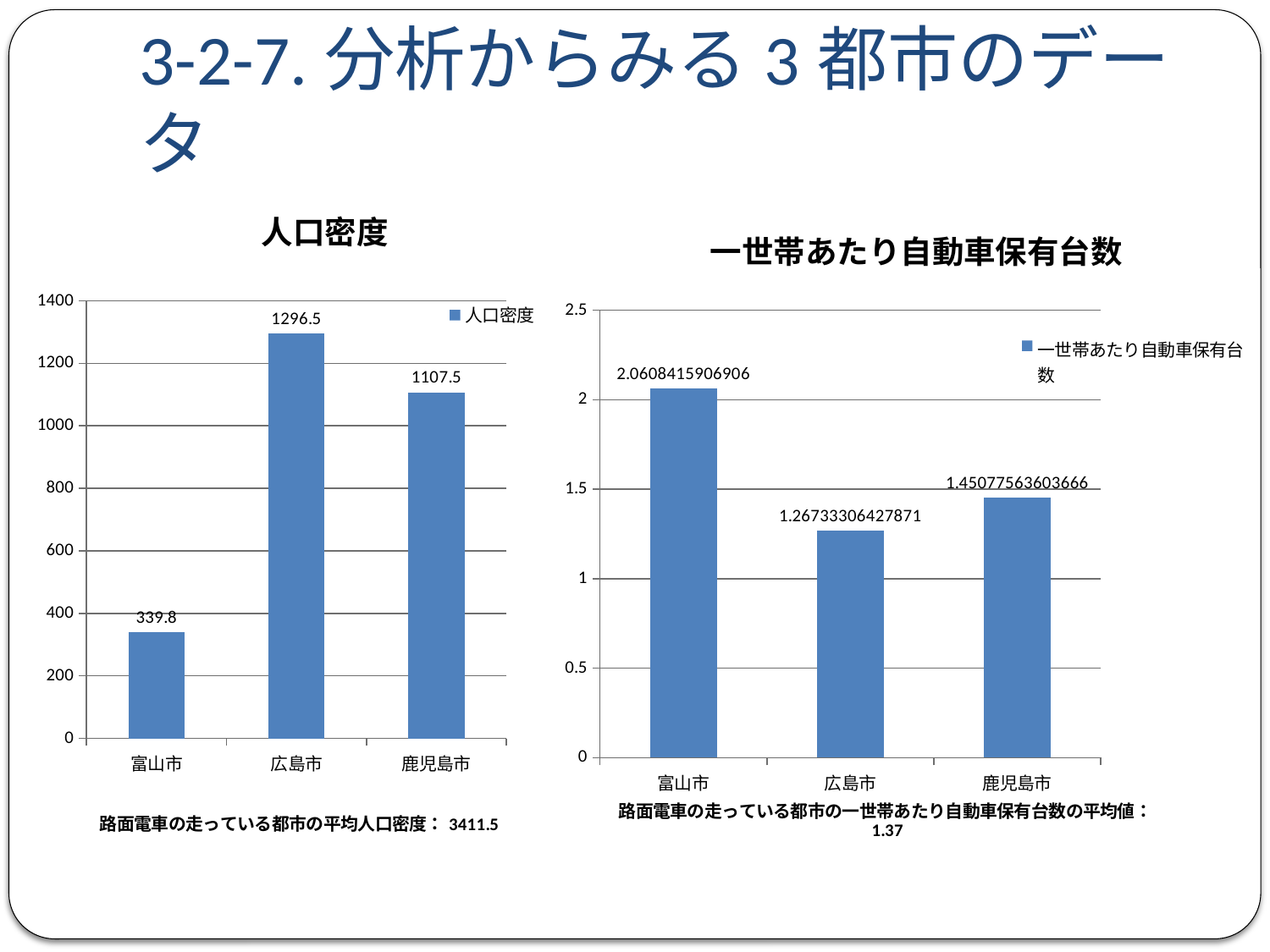
How many cities are shown in the 人口密度 chart? 3 In the 一世帯あたり自動車保有台数 chart, which is larger: the value for 鹿児島市 or 広島市? 鹿児島市 In the 人口密度 chart, what is the value for 富山市? 339.8 In the 人口密度 chart, which city has the highest population density? 広島市 In the 一世帯あたり自動車保有台数 chart, what is the value for 鹿児島市? 1.45077563603666 What type of chart is the 一世帯あたり自動車保有台数 chart? bar chart In the 一世帯あたり自動車保有台数 chart, is the value for 富山市 greater or less than 2? greater In the 人口密度 chart, what is the difference between the values for 広島市 and 鹿児島市? 189 In the 一世帯あたり自動車保有台数 chart, which city has the lowest value? 広島市 In the 人口密度 chart, what is the value for 広島市? 1296.5 In the 一世帯あたり自動車保有台数 chart, what is the value for 富山市? 2.0608415906906 In the 人口密度 chart, which city has the lowest value? 富山市